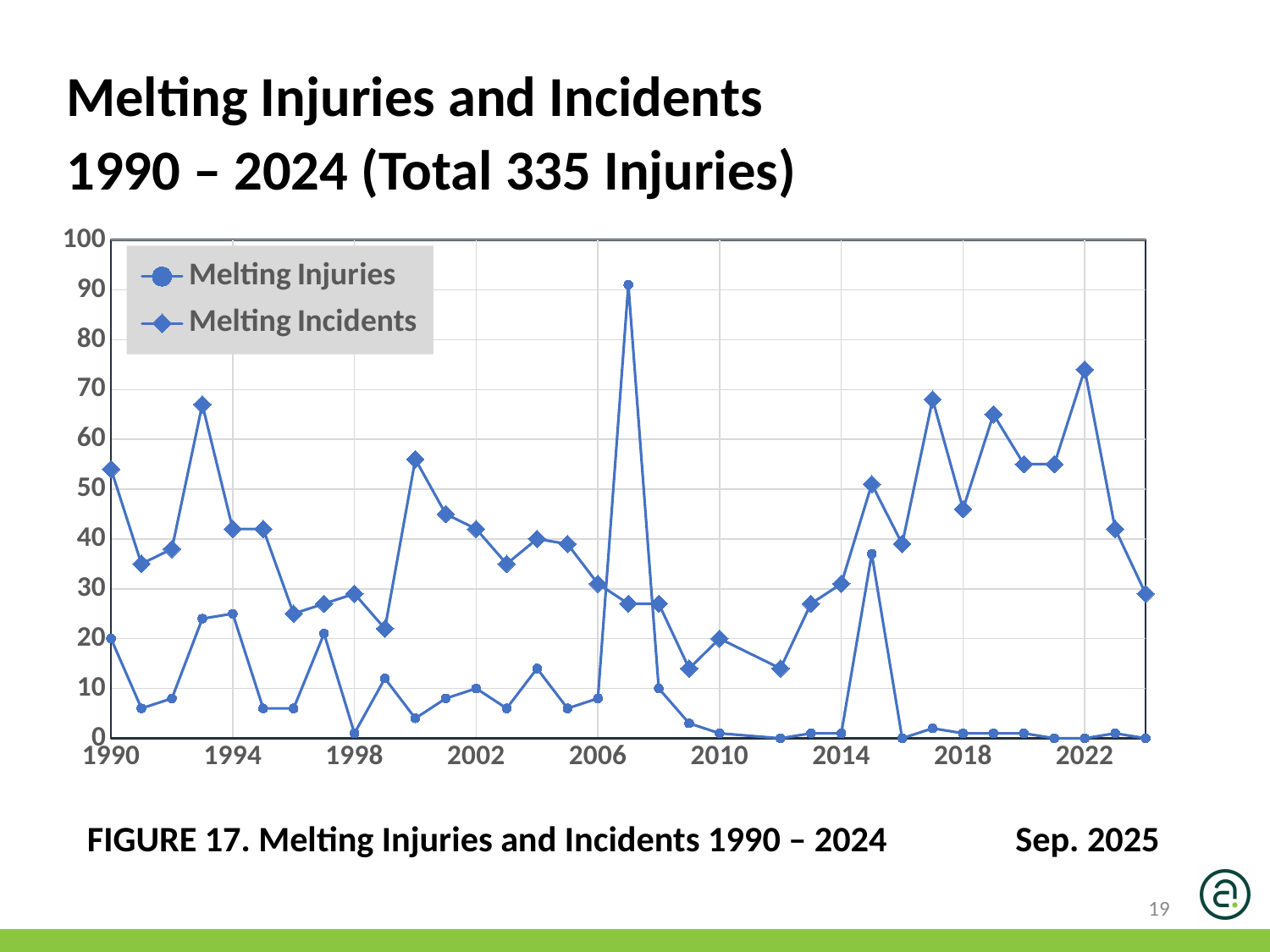
What kind of chart is shown on the slide? Line chart Do the Melting Incidents values rise or fall from 2012 to 2017? rise In which year does the Melting Injuries series reach its highest value? 2007 Is the value for Melting Injuries in 2015 greater or less than 30? greater Is the value for Melting Incidents in 2010 greater or less than 30? less How many series does the legend list? 2 Is the value for Melting Injuries in 2007 greater or less than 80? greater Do the Melting Injuries values rise or fall from 2007 to 2010? fall In which year does the Melting Incidents series reach its highest value? 2022 Which is larger for Melting Incidents, the value in 1993 or the value in 1994? 1993 Which series are listed in the legend? Melting Injuries and Melting Incidents